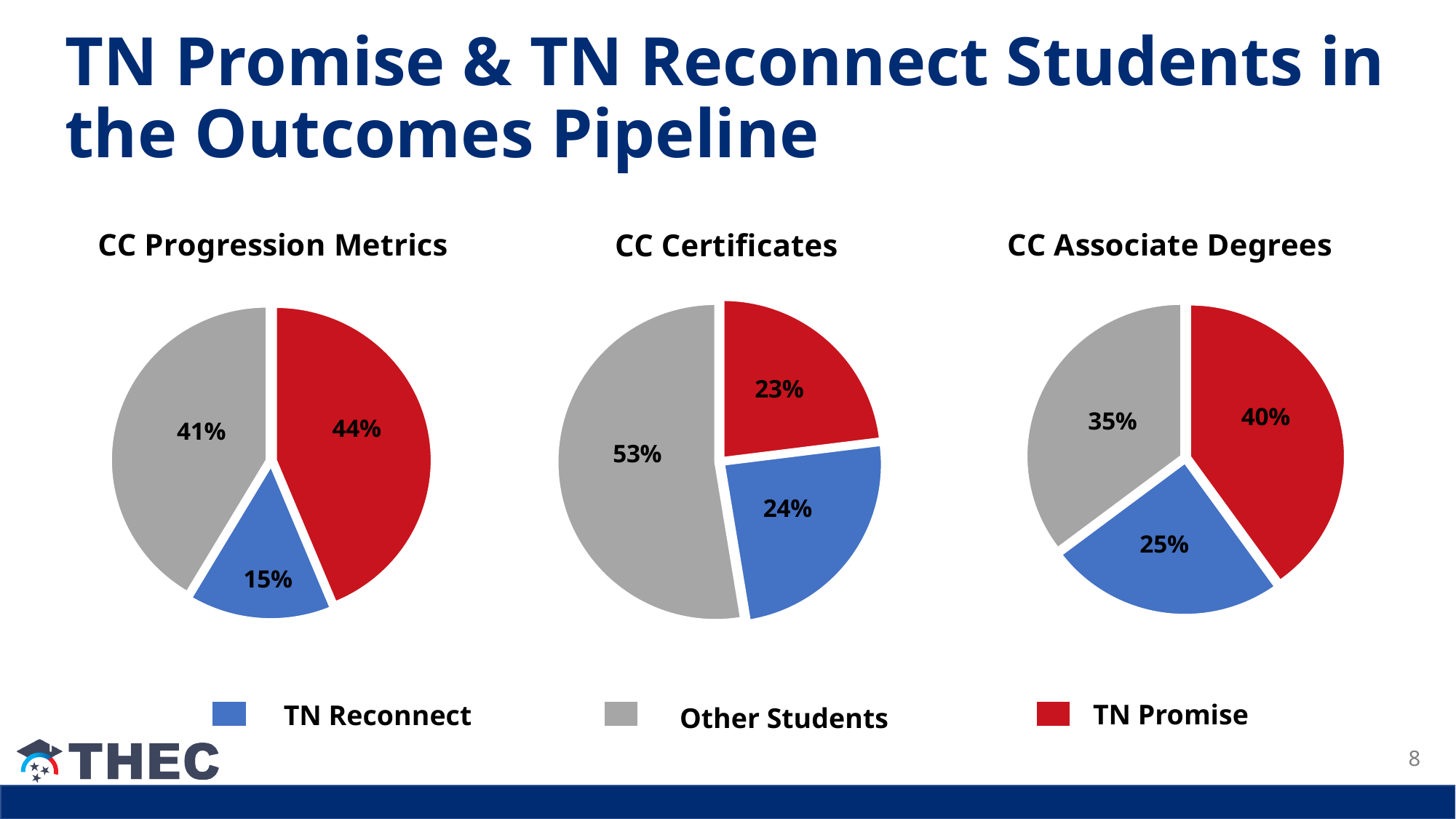
In the CC Associate Degrees chart, what share is TN Reconnect? 25% In the CC Certificates chart, what percentage is labelled for Other Students? 53% In the CC Associate Degrees chart, which group has the largest slice? TN Promise In the CC Progression Metrics chart, which group has the smallest slice? TN Reconnect In the CC Progression Metrics chart, what share of students are TN Promise students? 44% In the CC Certificates chart, is the TN Reconnect slice larger or smaller than the Other Students slice? smaller In the CC Associate Degrees chart, what is the difference between the Other Students and TN Reconnect shares? 10% Which colour represents TN Reconnect in the legend? blue In the CC Progression Metrics chart, what is the difference between the TN Promise and TN Reconnect shares? 29% How many slices does the CC Certificates chart have? 3 In the CC Certificates chart, which group has the smallest slice? TN Promise What type of chart is used for CC Associate Degrees? pie chart